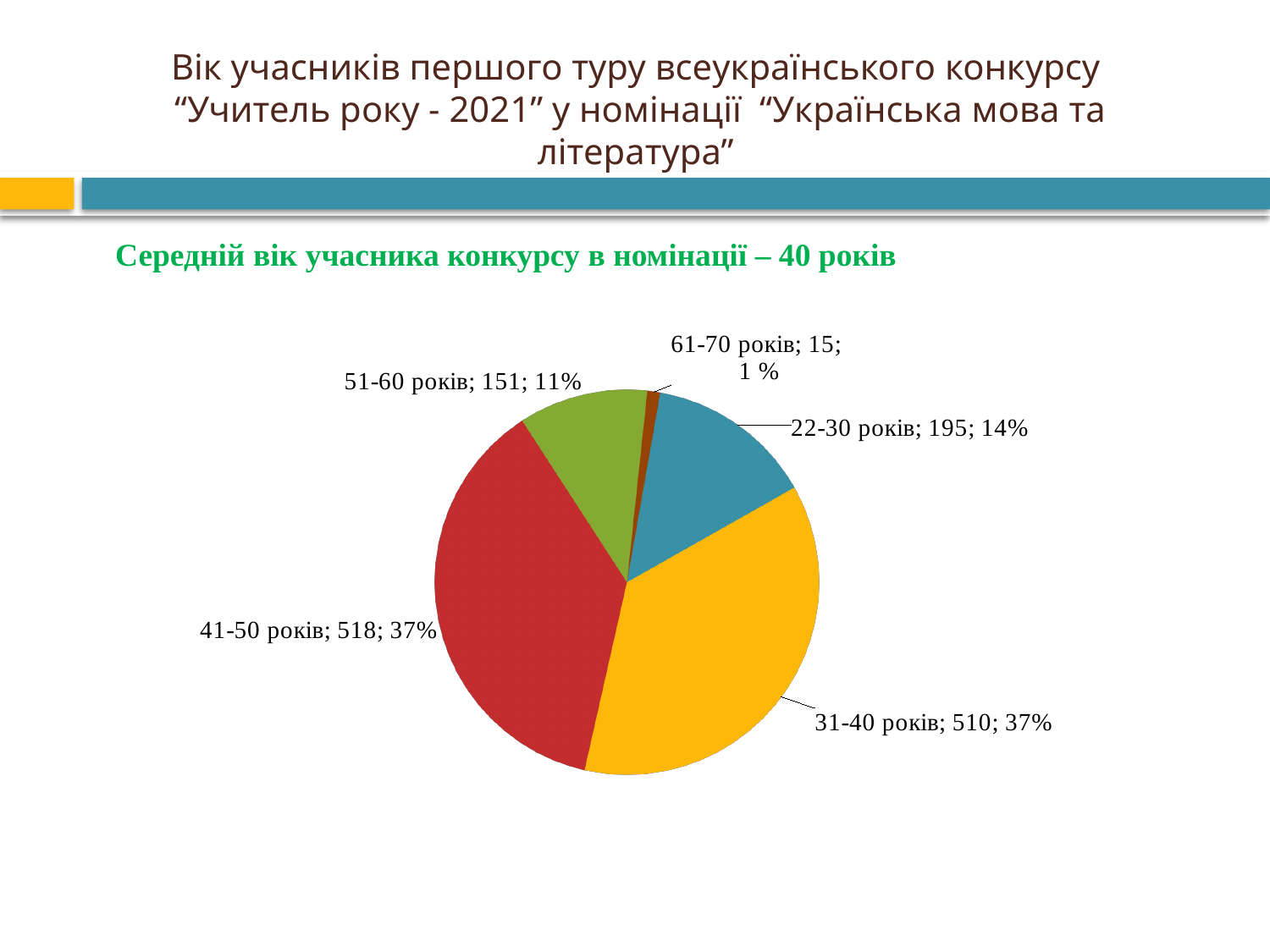
Which age group has the smallest number of participants? 61-70 років What share of the pie does the 22-30 років group represent? 14% How many age groups (slices) does the pie chart show? 5 How many participants are in the 61-70 років age group? 15 What share of the pie does the 31-40 років group represent? 37% How many participants are in the 22-30 років age group? 195 What is the difference in participants between the 41-50 років and 31-40 років groups? 8 Which age group has the largest number of participants? 41-50 років According to the text on the slide, what is the average age of a participant in the nomination? 40 років What kind of chart is shown on the slide? pie chart How many participants are in the 51-60 років age group? 151 Which group has more participants, 22-30 років or 51-60 років? 22-30 років